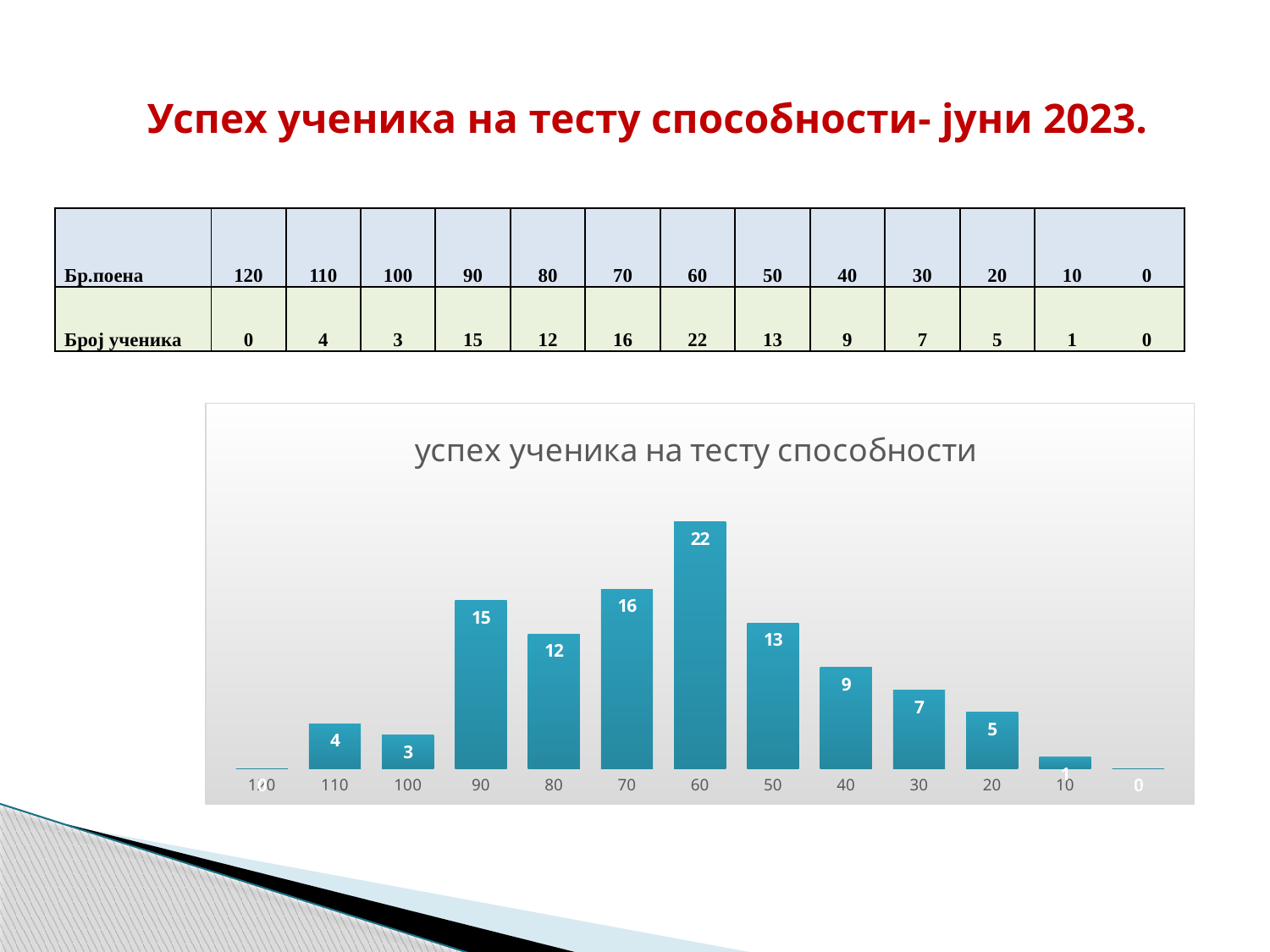
What is the value for the 110 category? 4 Which is larger, the value for 70 or the value for 80? 70 Which category has the highest value? 60 Do the values rise or fall from the 60 category to the 0 category along the x axis? fall What is the title of the chart? успех ученика на тесту способности What type of chart is shown on the slide? bar chart What is the difference between the values for 90 and 100? 12 What is the value for the 90 category? 15 What is the difference between the values for 60 and 50? 9 What is the value for the 60 category? 22 Which category has the lowest non-zero value? 10 How many categories are shown on the x axis of the chart? 13